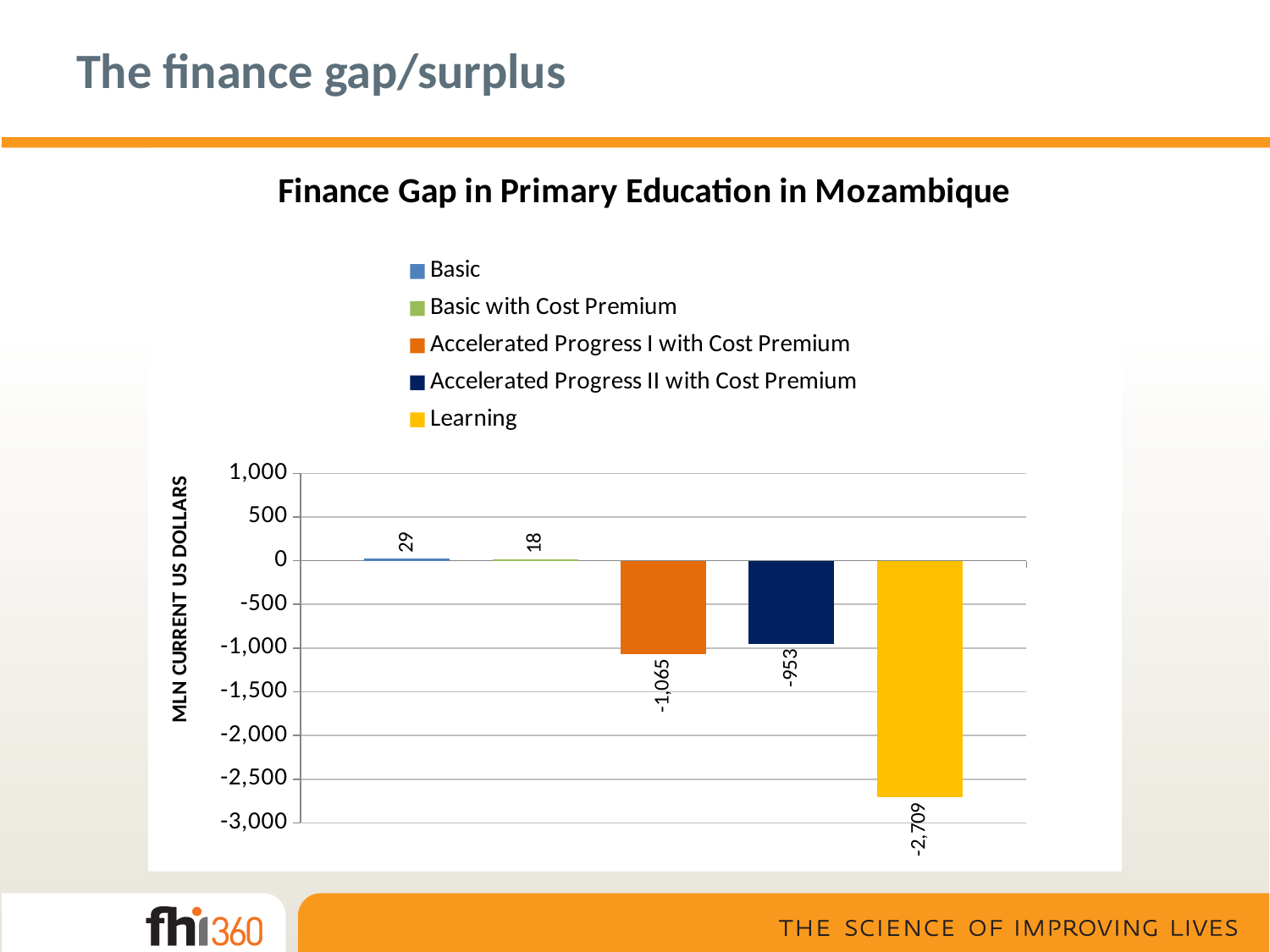
What is the value for Accelerated Progress I with Cost Premium? -1,065 What is the value for Basic with Cost Premium? 18 How many series does the legend list? 5 Which series has the lowest value? Learning What is the value for Accelerated Progress II with Cost Premium? -953 What kind of chart is shown? Bar chart What is the difference between the values for Accelerated Progress I with Cost Premium and Accelerated Progress II with Cost Premium? 112 Which is larger, the value for Basic or the value for Basic with Cost Premium? Basic What is the label on the vertical axis? MLN CURRENT US DOLLARS What is the value for Basic? 29 What is the value for Learning? -2,709 Which series has the highest value? Basic